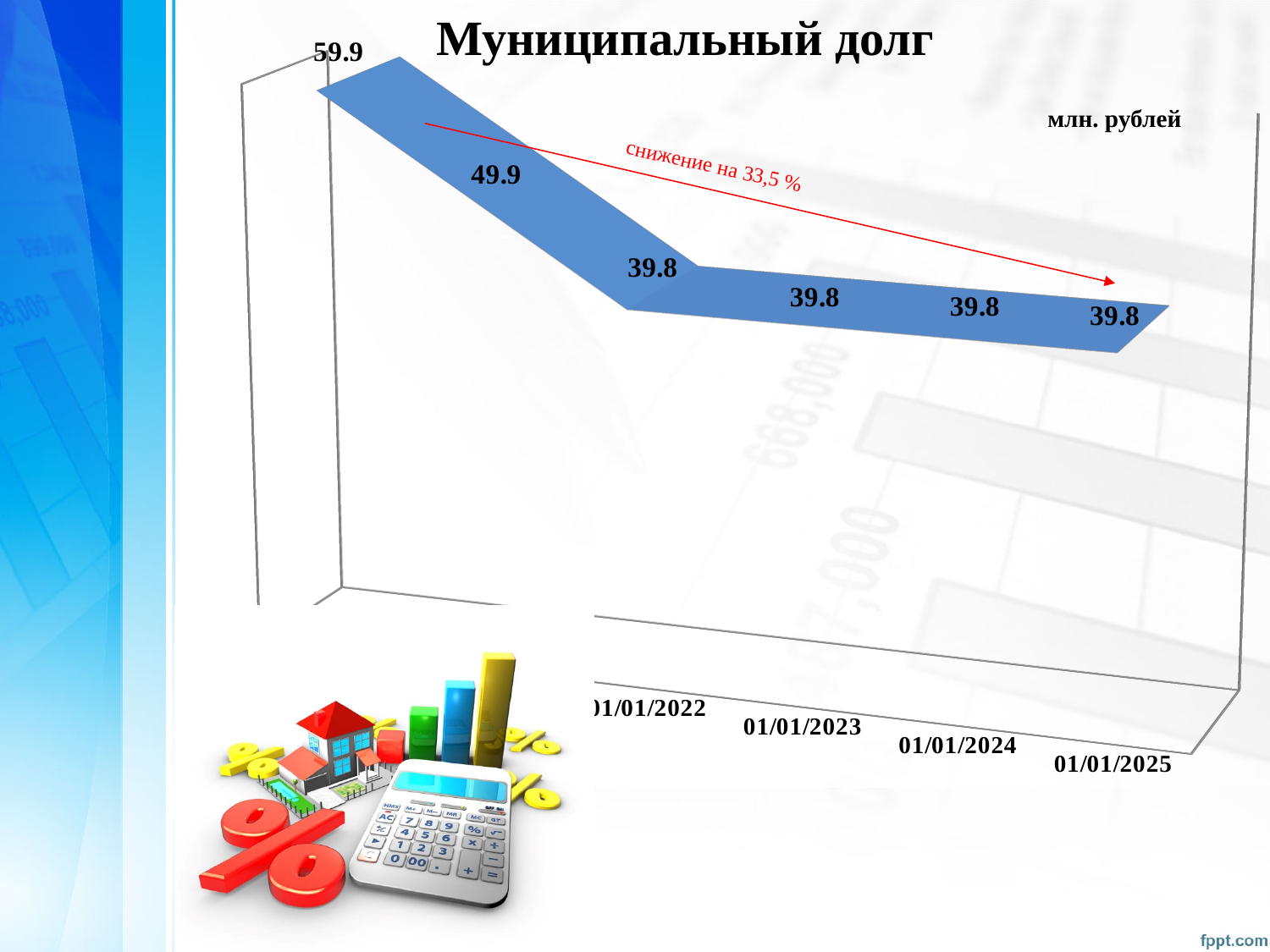
Is the value on 01/01/2024 larger or smaller than the first value on the chart? smaller What kind of chart is shown on the slide? line chart What is the difference between the highest value and the value on 01/01/2025? 20.1 What is the highest value shown on the chart? 59.9 Do the values rise or fall along the x axis? fall What is the value of municipal debt on 01/01/2023? 39.8 What is the value of municipal debt on 01/01/2025? 39.8 How many data points are plotted on the chart? 6 What is the lowest value shown on the chart? 39.8 What is the difference between the first value (59.9) and the second value (49.9) on the chart? 10 What is the title of the chart? Муниципальный долг In what units are the values on the chart given? млн. рублей